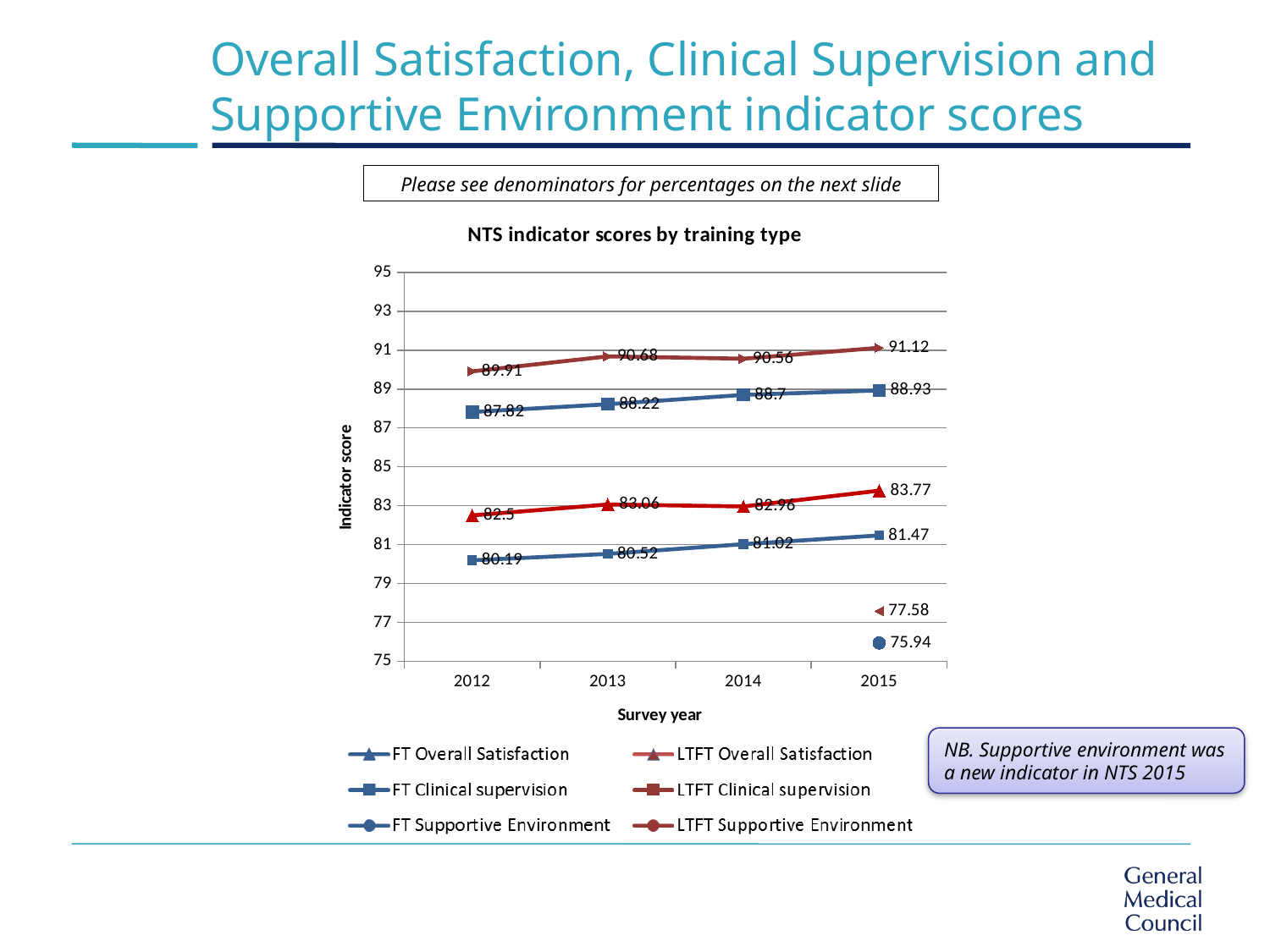
What is the lowest value labelled on the chart? 75.94 What is the FT Clinical supervision score in 2012? 87.82 What type of chart is shown on the slide? line chart By how much did the FT Clinical supervision score increase from 2012 (87.82) to 2015 (88.93)? 1.11 Does the FT Clinical supervision line rise or fall from 2012 to 2015? rise What is the LTFT Supportive Environment indicator score in 2015? 77.58 In 2015, which is larger: the FT Supportive Environment score or the LTFT Supportive Environment score? LTFT Supportive Environment What is the FT Supportive Environment indicator score in 2015? 75.94 What is the title of the x axis of the chart? Survey year How many survey years are shown on the x axis of the chart? 4 What is the highest value labelled on the chart? 91.12 How many series does the legend of the 'NTS indicator scores by training type' chart list? 6